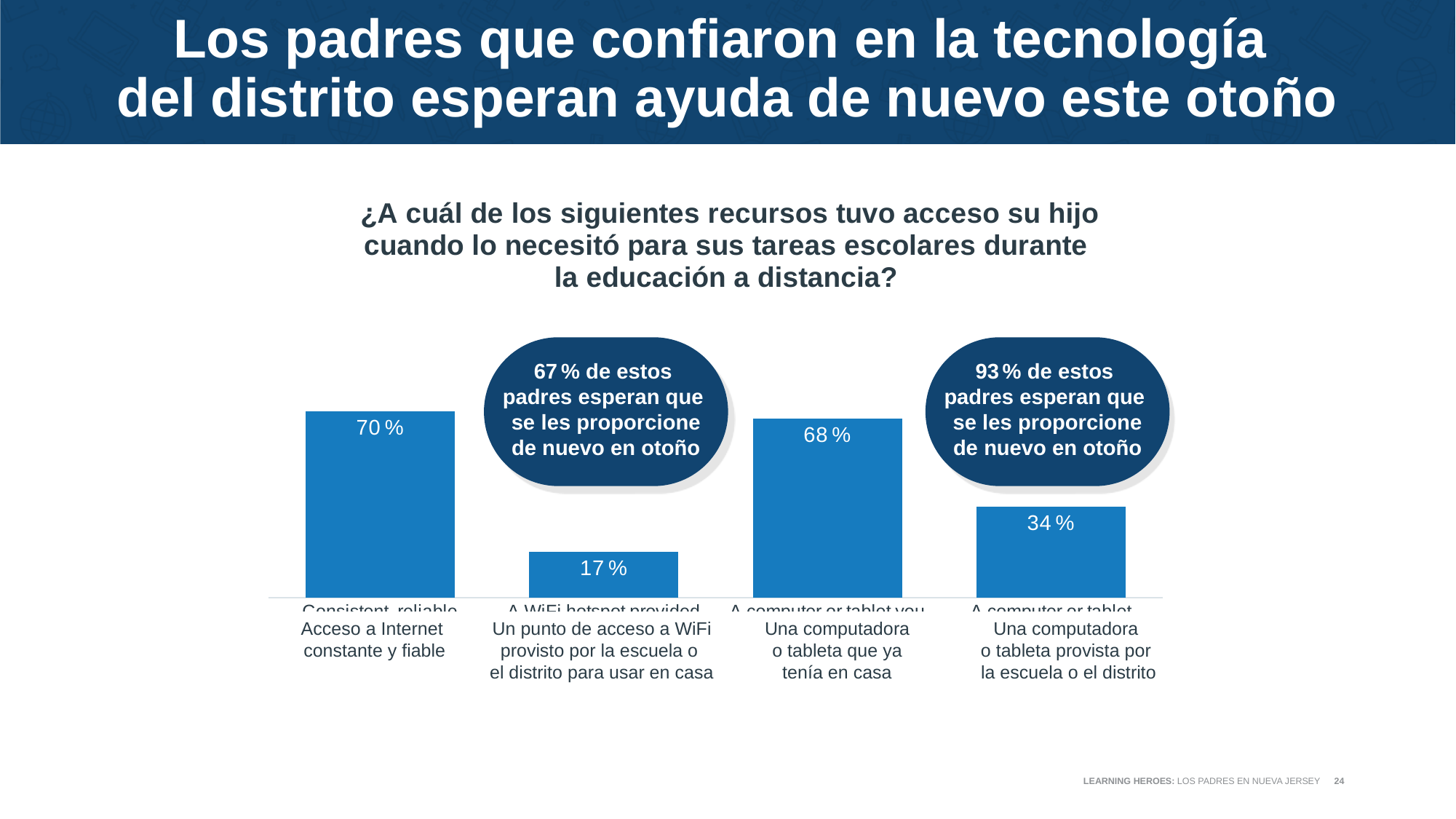
What percentage is shown for 'Una computadora o tableta que ya tenía en casa'? 68 % What is the difference between the value for 'Una computadora o tableta que ya tenía en casa' and the value for 'Una computadora o tableta provista por la escuela o el distrito'? 34 % What value is shown for the bar 'Un punto de acceso a WiFi provisto por la escuela o el distrito para usar en casa'? 17 % According to the callout above the school-provided computer or tablet bar, what percentage of these parents expect it to be provided again in the fall? 93 % What percentage of parents said their child had access to consistent, reliable Internet (Acceso a Internet constante y fiable)? 70 % According to the callout above the WiFi hotspot bar, what percentage of these parents expect it to be provided again in the fall? 67 % Which category has the highest value in the chart? Acceso a Internet constante y fiable Which is larger: the value for 'Acceso a Internet constante y fiable' or the value for 'Una computadora o tableta provista por la escuela o el distrito'? Acceso a Internet constante y fiable What percentage is shown for 'Una computadora o tableta provista por la escuela o el distrito'? 34 % Which category has the lowest value in the chart? Un punto de acceso a WiFi provisto por la escuela o el distrito para usar en casa How many categories (bars) does the chart show? 4 What kind of chart is shown on the slide? Bar chart